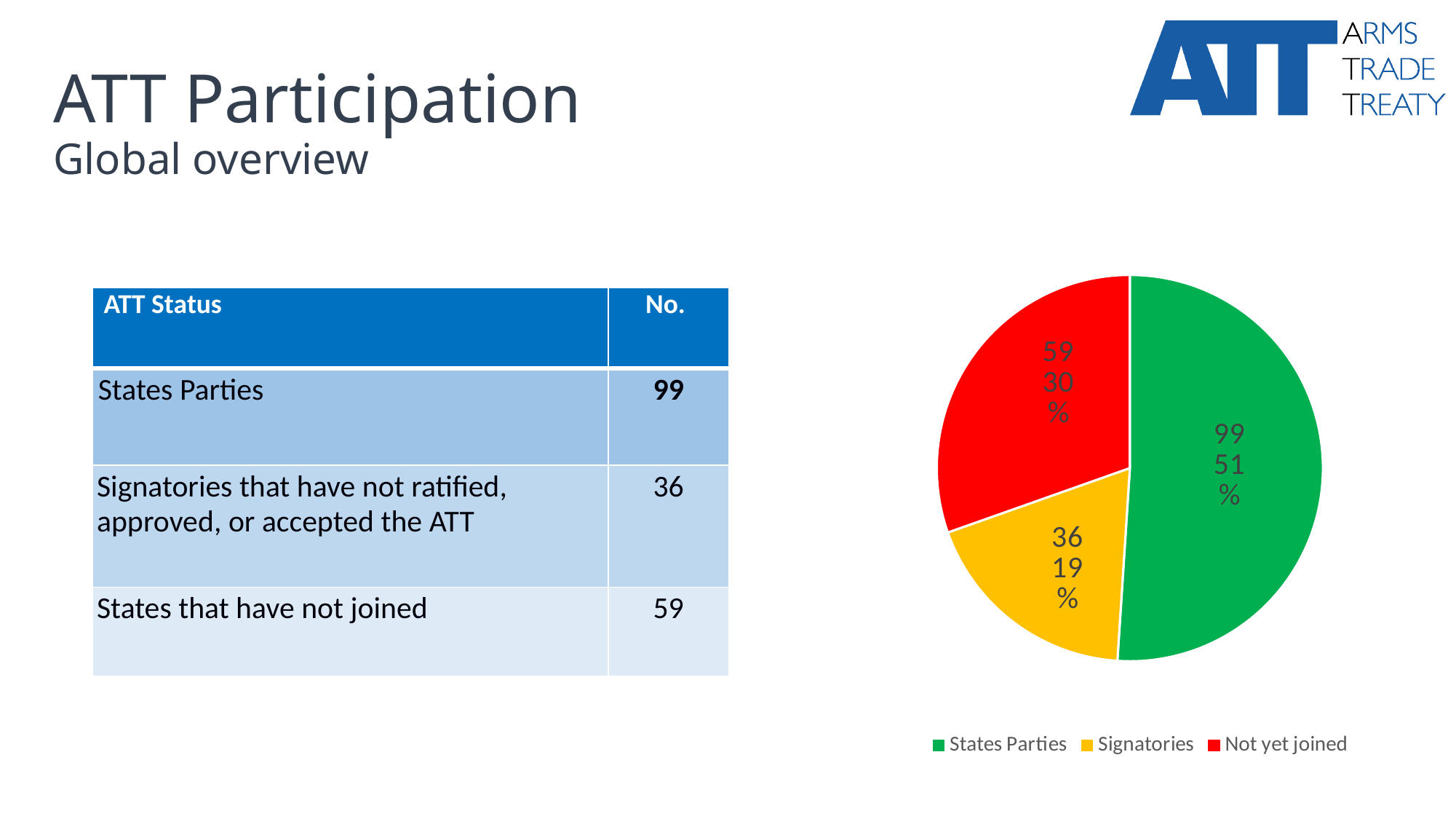
Which slice of the pie chart is the smallest? Signatories Which colour represents Signatories in the pie chart? yellow How many entries does the pie chart's legend list? 3 What is the value shown for Signatories in the pie chart? 36 What is the value shown for States Parties in the pie chart? 99 Which slice of the pie chart is the largest? States Parties What is the difference between the values for States Parties and Not yet joined in the pie chart? 40 How many slices does the pie chart have? 3 What kind of chart is shown on the slide? pie chart What percentage share of the pie does States Parties have? 51% What is the value shown for Not yet joined in the pie chart? 59 What percentage share of the pie does Not yet joined have? 30%